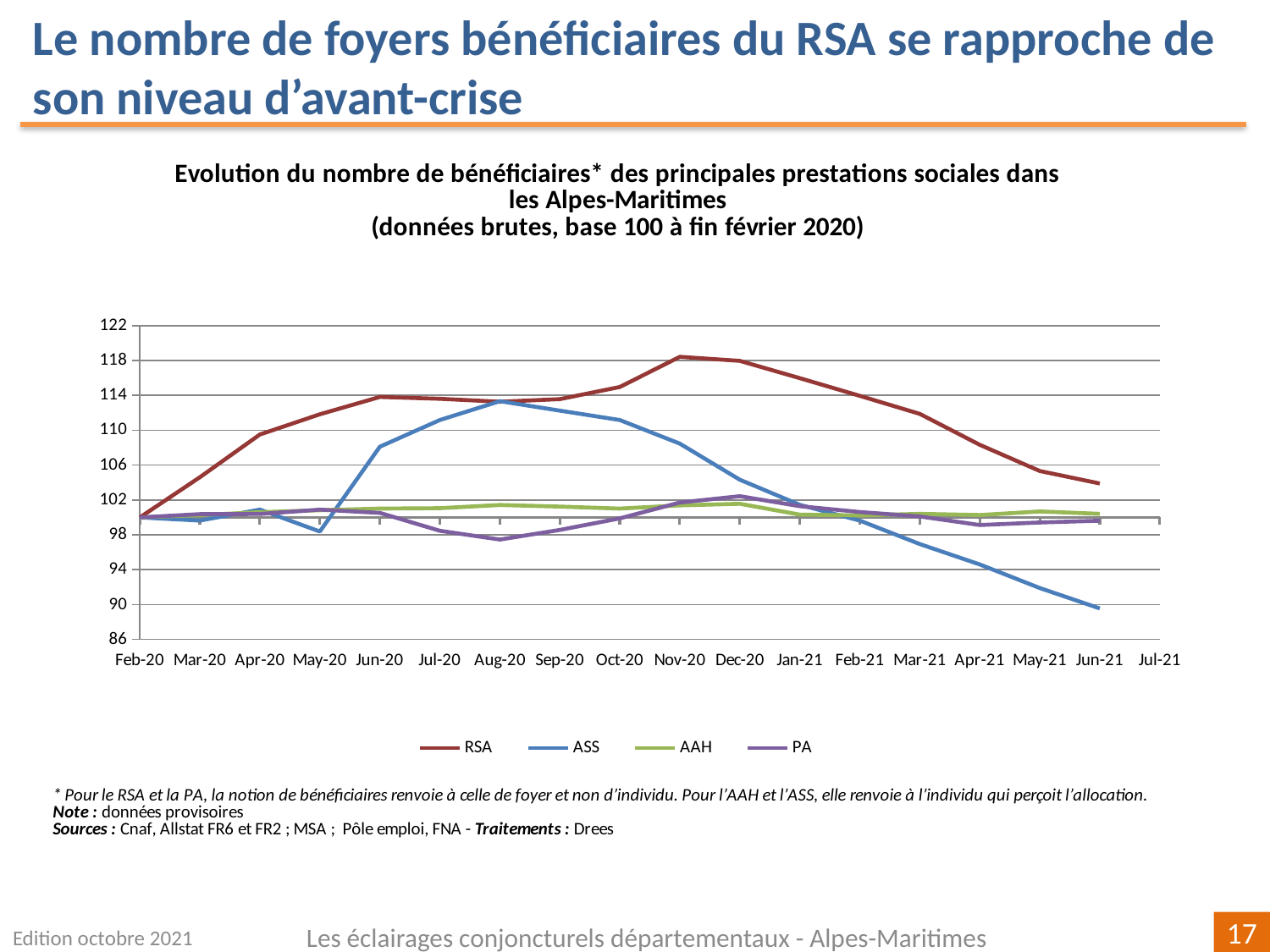
Does the RSA series rise or fall between Feb-20 and Nov-20? rise How many series does the chart legend list? 4 Is the value for ASS at Jun-21 greater or less than 94? less Which series has the lowest value at Jun-21? ASS Does the ASS series rise or fall between Dec-20 and Jun-21? fall What colour is the RSA line in the chart? dark red What kind of chart is shown on the slide? line chart Which series reaches the highest value on the chart? RSA At Aug-20, which is larger, the ASS value or the PA value? ASS At Jun-21, which is larger, the RSA value or the ASS value? RSA Is the value for RSA at Nov-20 greater or less than 114? greater Is the value for ASS at Aug-20 greater or less than 110? greater